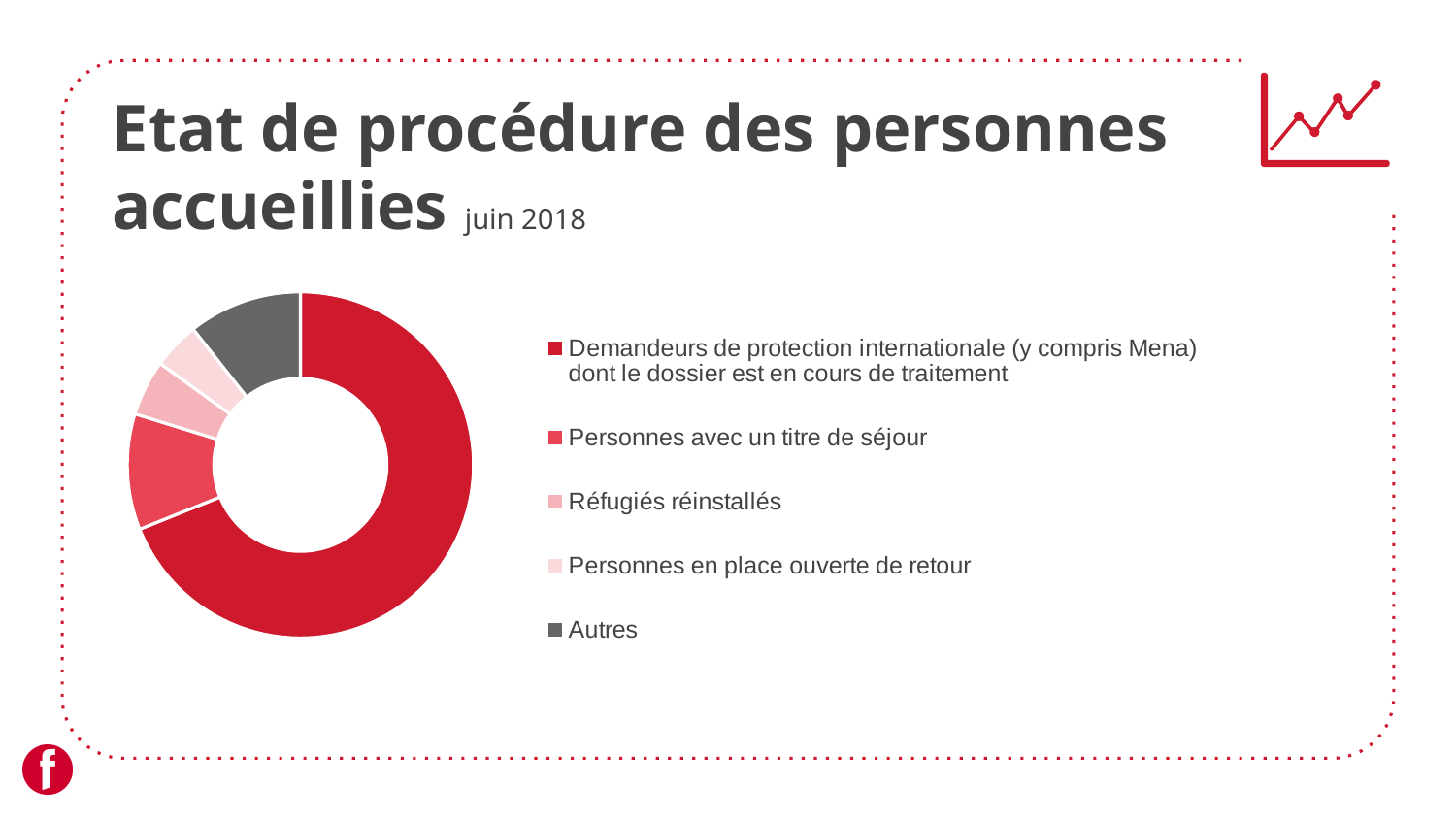
What kind of chart is shown on the slide? Pie chart (donut) How many categories does the pie chart show? 5 Which is larger: the slice for 'Demandeurs de protection internationale' or the slice for 'Autres'? Demandeurs de protection internationale Which is larger: the slice for 'Demandeurs de protection internationale' or the slice for 'Personnes avec un titre de séjour'? Demandeurs de protection internationale What is the title of the slide containing the pie chart? Etat de procédure des personnes accueillies juin 2018 How many entries does the legend of the pie chart list? 5 Which legend entry is shown in grey in the pie chart? Autres Which category has the largest share of the pie chart? Demandeurs de protection internationale (y compris Mena) dont le dossier est en cours de traitement Does the largest slice of the pie chart take up more or less than half of the pie? more